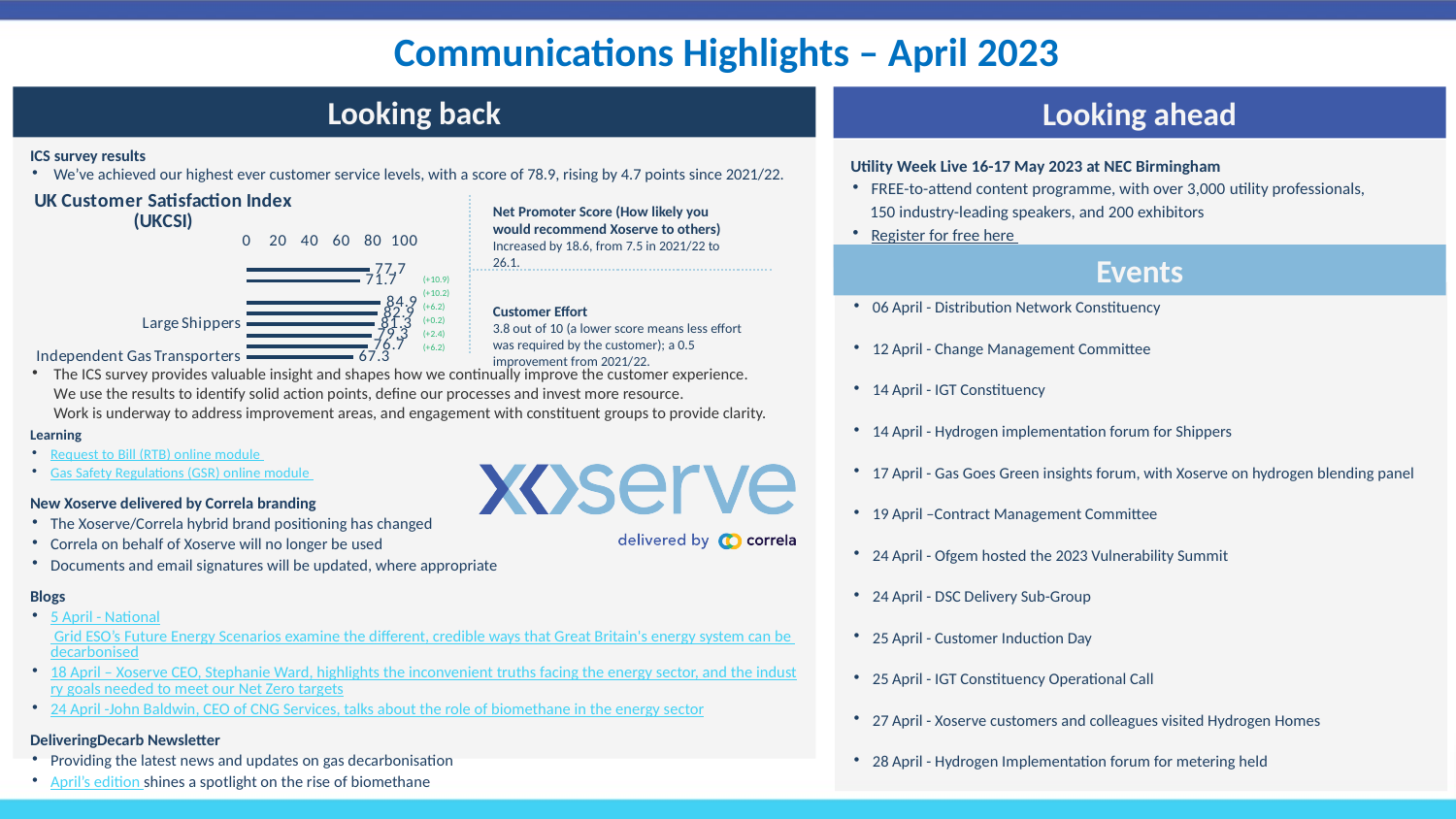
What is the title of the chart on the left side of the slide? UK Customer Satisfaction Index (UKCSI) In the UKCSI chart, which category has the lowest value? Independent Gas Transporters What kind of chart is the UK Customer Satisfaction Index (UKCSI) chart? bar chart In the UKCSI chart, is the value for Independent Gas Transporters greater or less than 80? less In the UKCSI chart, is the value for Independent Gas Transporters greater or less than 60? greater In the UKCSI chart, what is the highest data label shown? 84.9 In the UKCSI chart, what is the value for Independent Gas Transporters? 67.3 In the UKCSI chart, how many data labels (bars) are shown? 8 In the UKCSI chart, what is the highest tick value shown on the axis? 100 In the UKCSI chart, what is the lowest data label shown? 67.3 In the UKCSI chart, what is the difference between the highest value (84.9) and the value for Independent Gas Transporters (67.3)? 17.6